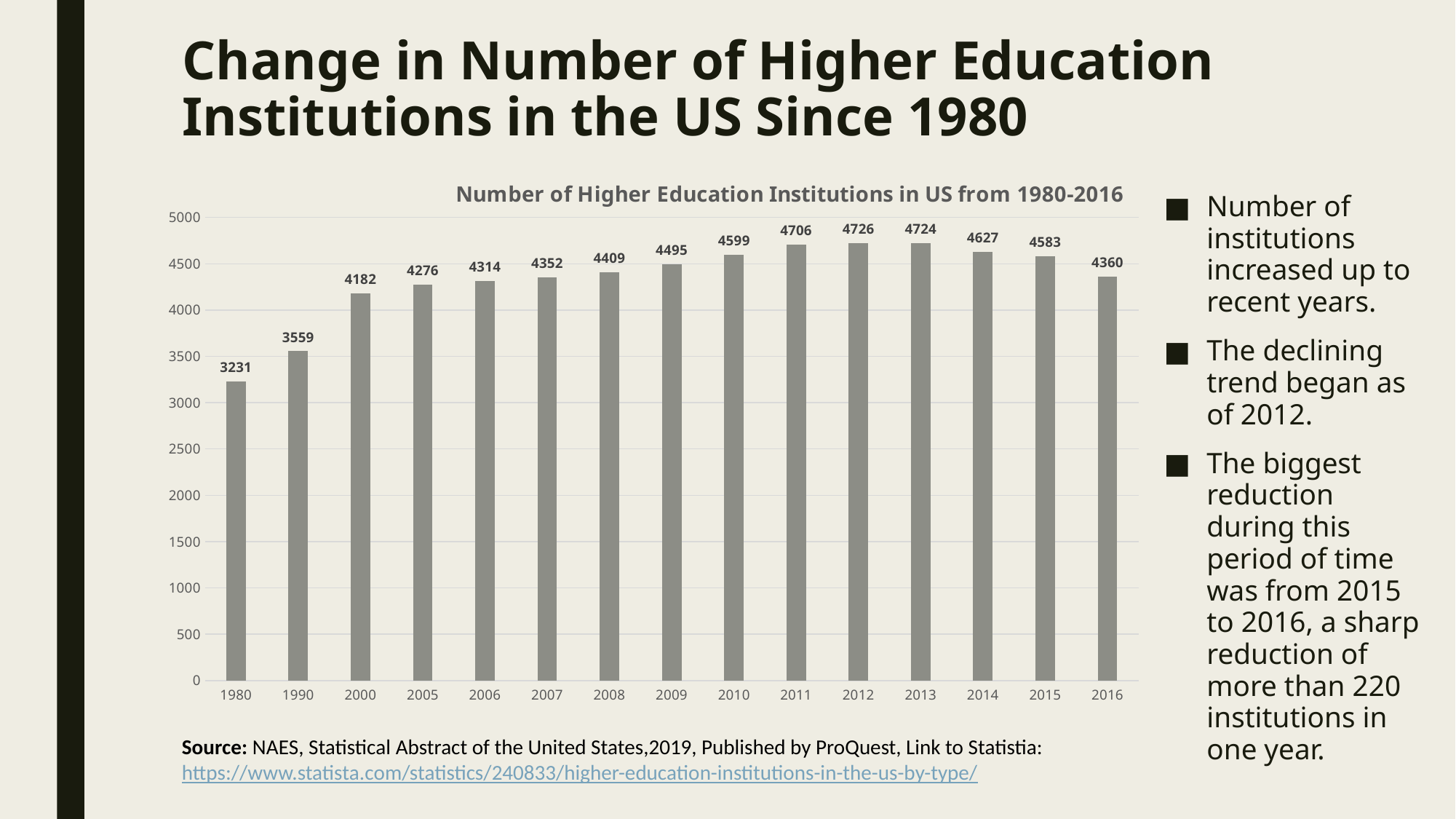
Which year has the lowest number of institutions? 1980 Is the value for 2000 greater or less than 4000? greater Which year has a larger value, 2011 or 2014? 2011 What is the value shown for 2016? 4360 How many years are shown on the x axis? 15 What is the difference between the values for 2015 and 2016? 223 What is the difference between the values for 1990 and 1980? 328 What kind of chart is shown on the slide? Bar chart Which year has the highest number of institutions? 2012 What is the title of the chart? Number of Higher Education Institutions in US from 1980-2016 What is the value shown for 2009? 4495 What is the number of higher education institutions in 1980? 3231